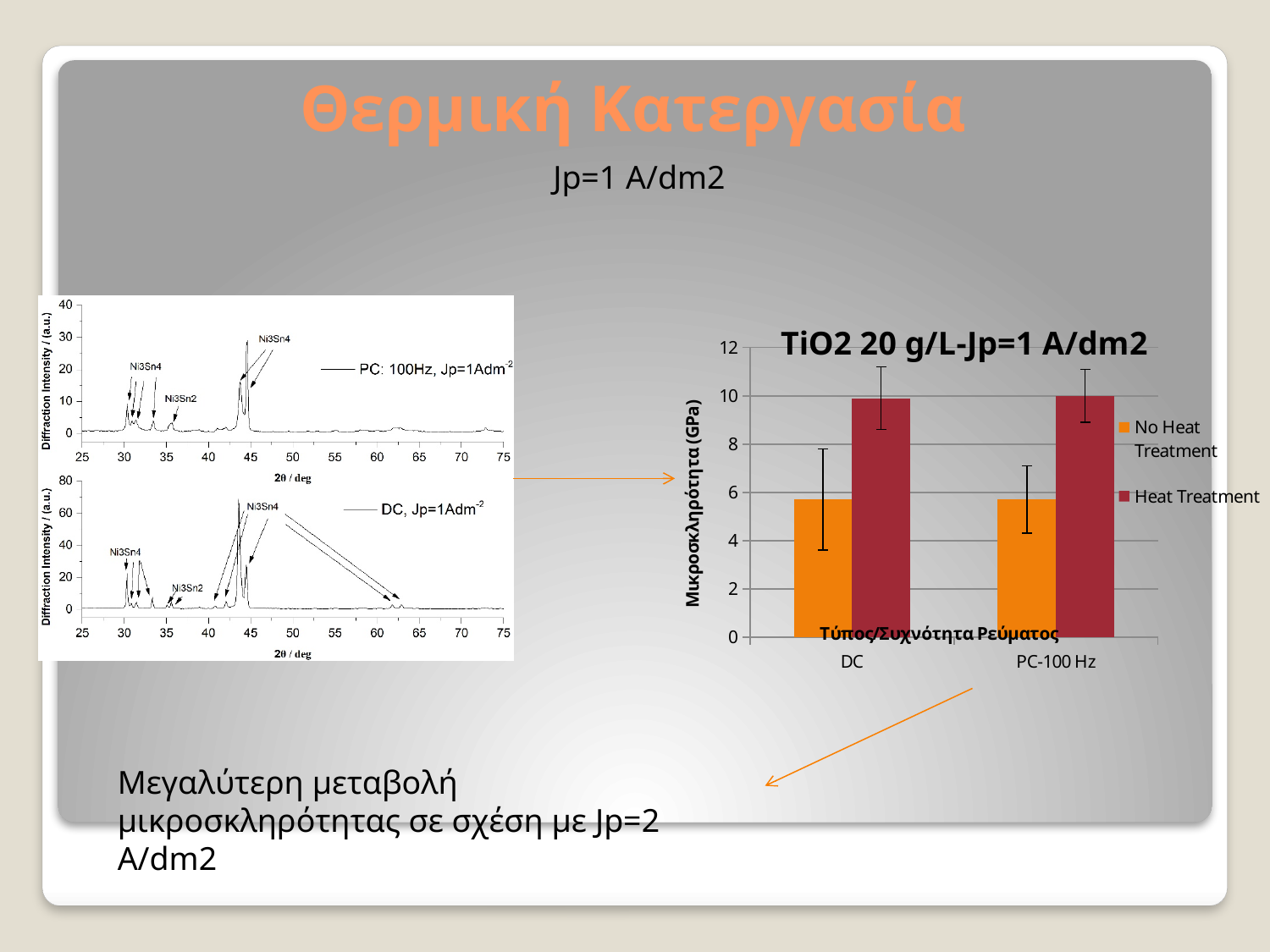
In the bar chart titled "TiO2 20 g/L-Jp=1 A/dm2", for DC, which is larger: the No Heat Treatment value or the Heat Treatment value? Heat Treatment In the bar chart titled "TiO2 20 g/L-Jp=1 A/dm2", is the No Heat Treatment value for DC greater or less than 8? less In the bar chart titled "TiO2 20 g/L-Jp=1 A/dm2", how many series does the legend list? 2 In the bar chart titled "TiO2 20 g/L-Jp=1 A/dm2", what is the label of the y axis? Μικροσκληρότητα (GPa) In the bar chart titled "TiO2 20 g/L-Jp=1 A/dm2", which series is shown in orange? No Heat Treatment In the bar chart titled "TiO2 20 g/L-Jp=1 A/dm2", what kind of chart is shown? bar chart In the bar chart titled "TiO2 20 g/L-Jp=1 A/dm2", for PC-100 Hz, which series has the higher value? Heat Treatment In the bar chart titled "TiO2 20 g/L-Jp=1 A/dm2", is the Heat Treatment value for PC-100 Hz greater or less than 8? greater In the bar chart titled "TiO2 20 g/L-Jp=1 A/dm2", is the No Heat Treatment value for PC-100 Hz greater or less than 8? less In the bar chart titled "TiO2 20 g/L-Jp=1 A/dm2", how many categories are shown on the x axis? 2